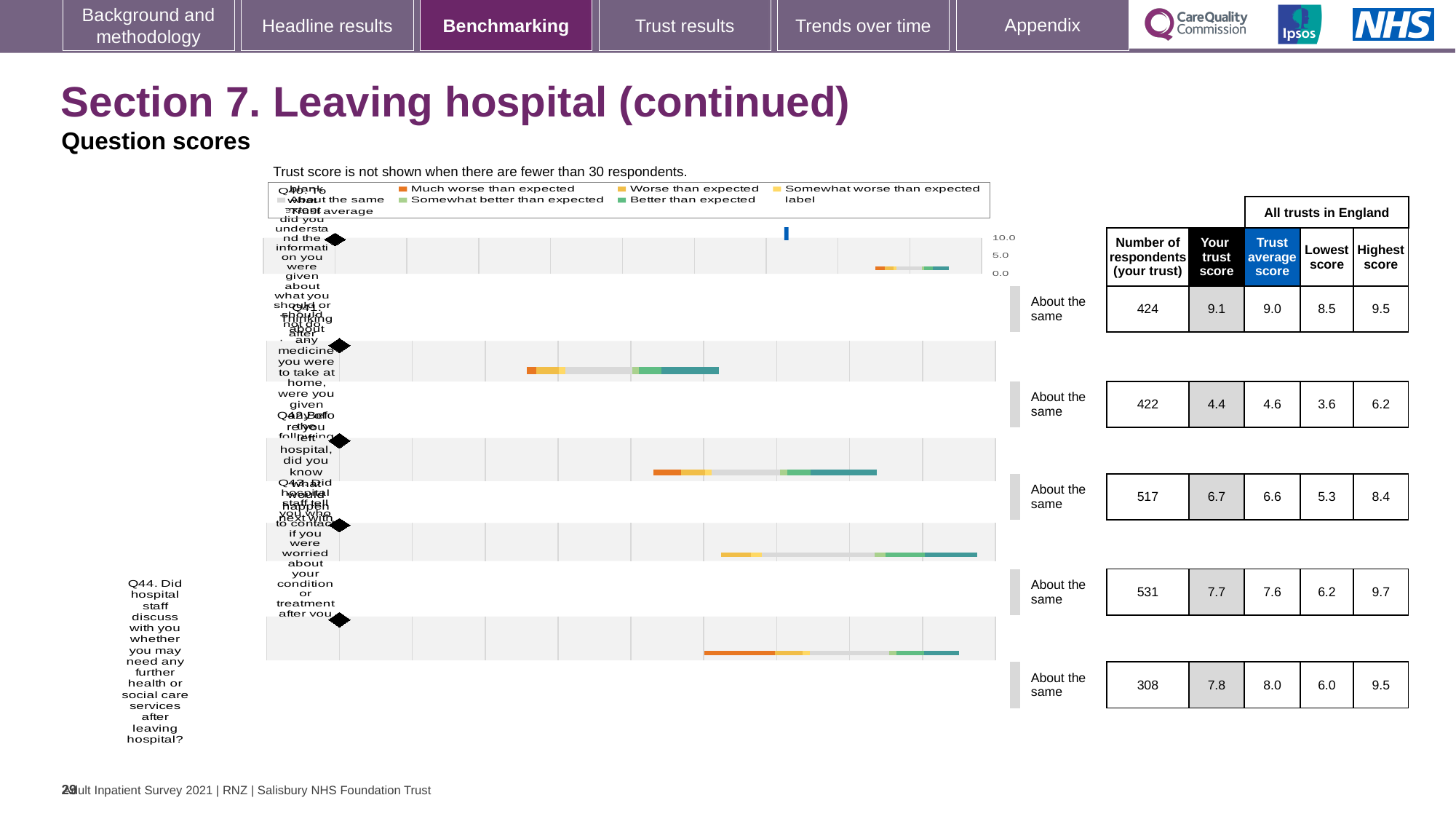
What is the highest 'Your trust score' value among the five questions shown? 9.1 What is the highest score across all trusts in England for Q44? 9.5 What is the lowest score across all trusts in England for Q44? 6.0 For Q44, what is the difference between the trust average score and the trust's own score? 0.2 What is the highest tick value shown on the chart's score axis? 10.0 For Q44, which is larger: the trust's own score or the trust average score? Trust average score What is the trust average score for Q44? 8.0 How many question rows are plotted in the benchmarking chart? 5 What kind of chart is used to show the question scores on this slide? bar chart How many respondents from the trust answered Q44? 308 What is the 'Your trust score' for Q44 (Did hospital staff discuss with you whether you may need any further health or social care services after leaving hospital?)? 7.8 What is the lowest 'Your trust score' value among the five questions shown? 4.4